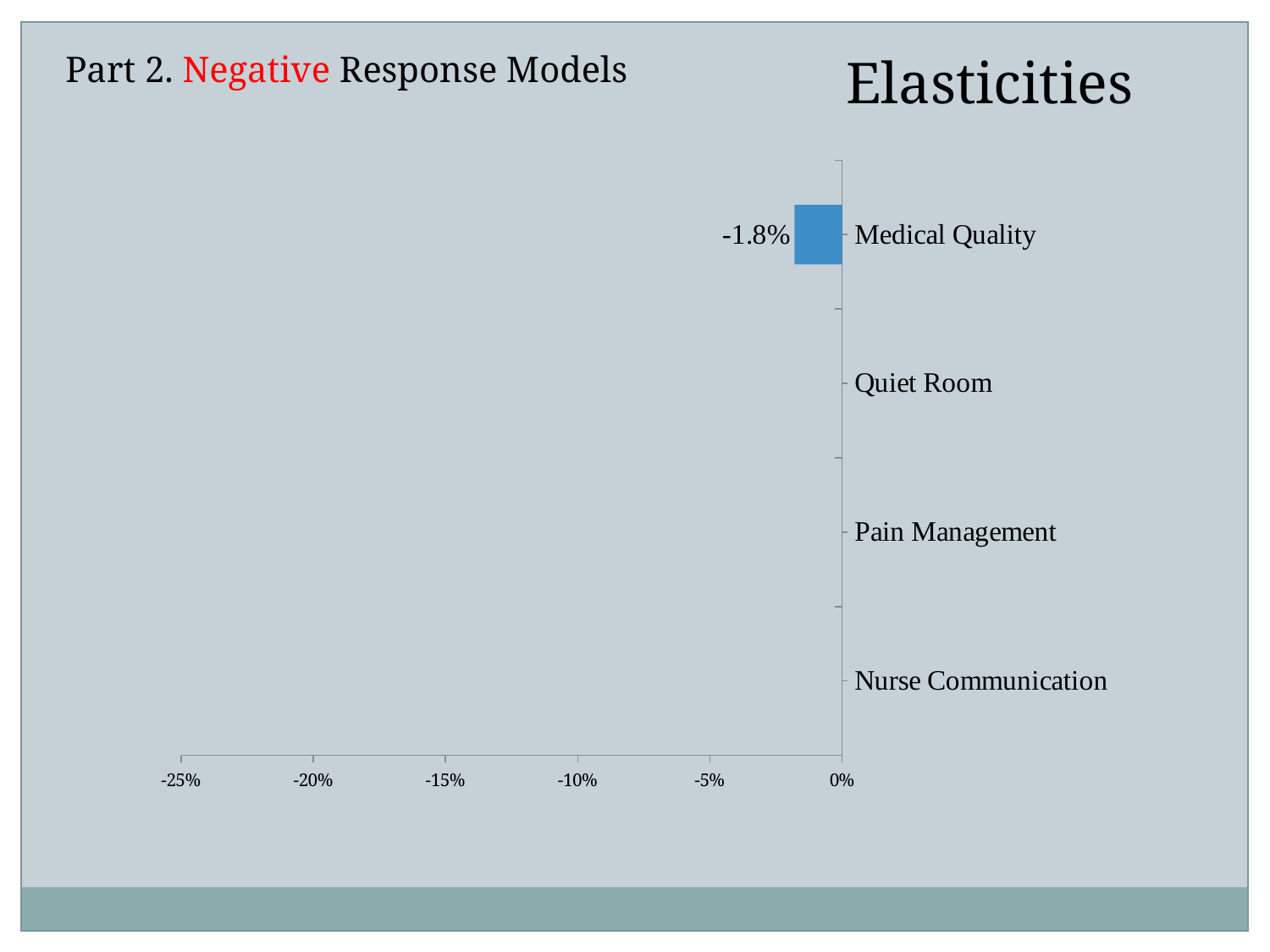
How many categories are listed on the vertical axis of the chart? 4 What is the value shown for Medical Quality? -1.8% Is the value for Medical Quality greater or less than -5%? greater What is the title of the chart? Elasticities What is the lowest value labelled on the horizontal axis? -25% Which category is listed at the top of the chart? Medical Quality What kind of chart is shown on the slide? bar chart